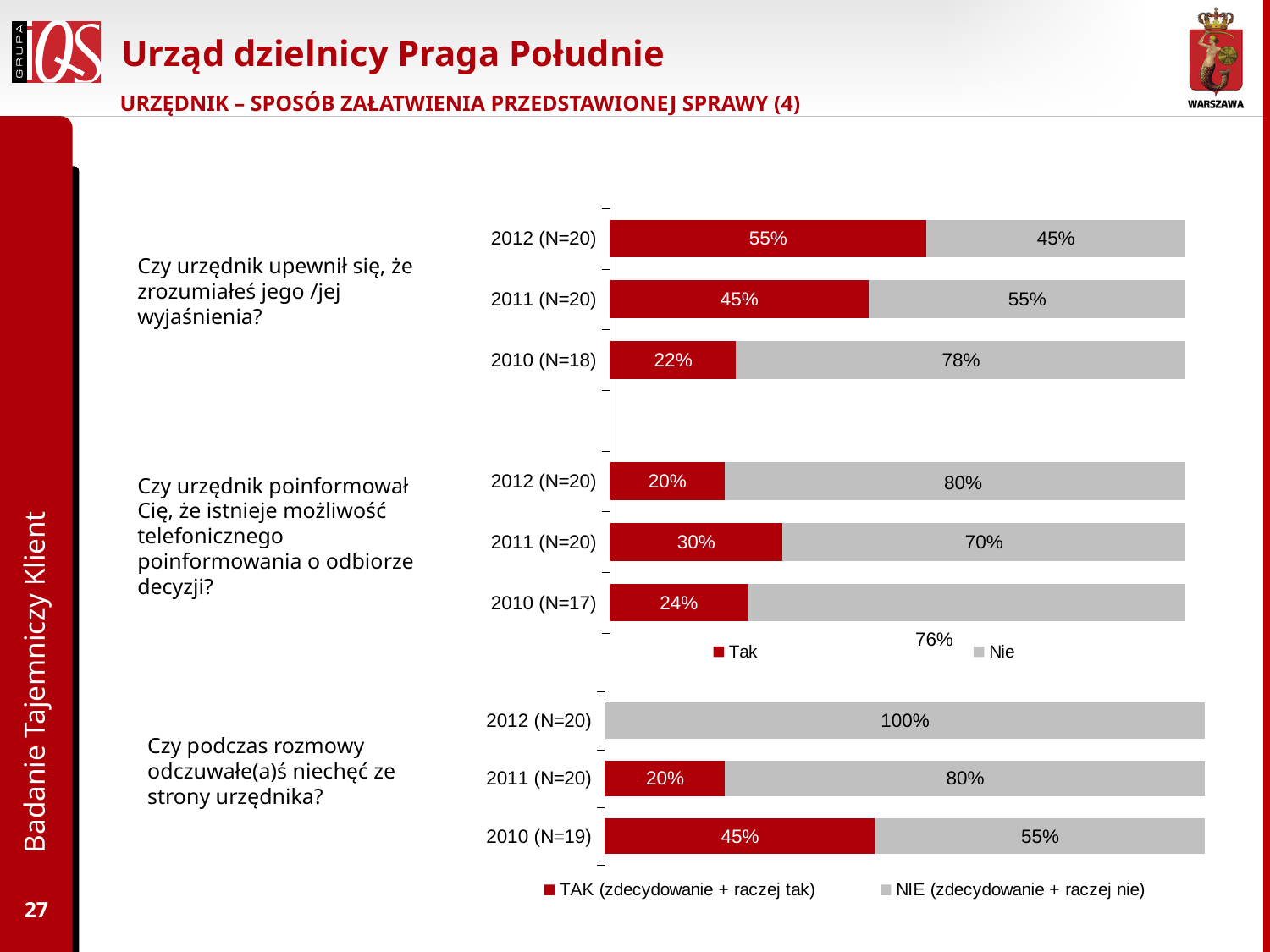
In the lower chart ('Czy podczas rozmowy odczuwałe(a)ś niechęć ze strony urzędnika?'), what is the 'TAK' value for 2010 (N=19)? 45% In the upper chart, for the question 'Czy urzędnik upewnił się, że zrozumiałeś jego/jej wyjaśnienia?', what is the 'Nie' value for 2010 (N=18)? 78% In the lower chart ('Czy podczas rozmowy odczuwałe(a)ś niechęć ze strony urzędnika?'), which is larger: the 'TAK' value for 2011 (N=20) or for 2010 (N=19)? 2010 (N=19) In the upper chart, for the question 'Czy urzędnik upewnił się, że zrozumiałeś jego/jej wyjaśnienia?', what is the difference between the 'Tak' values for 2012 (N=20) and 2010 (N=18)? 33 percentage points In the upper chart, for the question about telephone notification of the decision ('Czy urzędnik poinformował Cię, że istnieje możliwość telefonicznego poinformowania o odbiorze decyzji?'), what is the 'Tak' value for 2011 (N=20)? 30% In the upper chart, for the question about telephone notification of the decision, which year has the highest 'Nie' value? 2012 (N=20) In the lower chart ('Czy podczas rozmowy odczuwałe(a)ś niechęć ze strony urzędnika?'), what is the 'NIE' value for 2012 (N=20)? 100% How many series does the legend of the lower chart list? 2 In the upper chart, for the question 'Czy urzędnik upewnił się, że zrozumiałeś jego/jej wyjaśnienia?', does the 'Tak' value rise or fall from 2010 to 2012? rise What kind of chart is the lower chart on the slide? Stacked bar chart In the upper chart, for the question 'Czy urzędnik upewnił się, że zrozumiałeś jego/jej wyjaśnienia?', what is the 'Tak' value for 2012 (N=20)? 55% In the upper chart, for the question 'Czy urzędnik upewnił się, że zrozumiałeś jego/jej wyjaśnienia?', which year has the lowest 'Tak' value? 2010 (N=18)